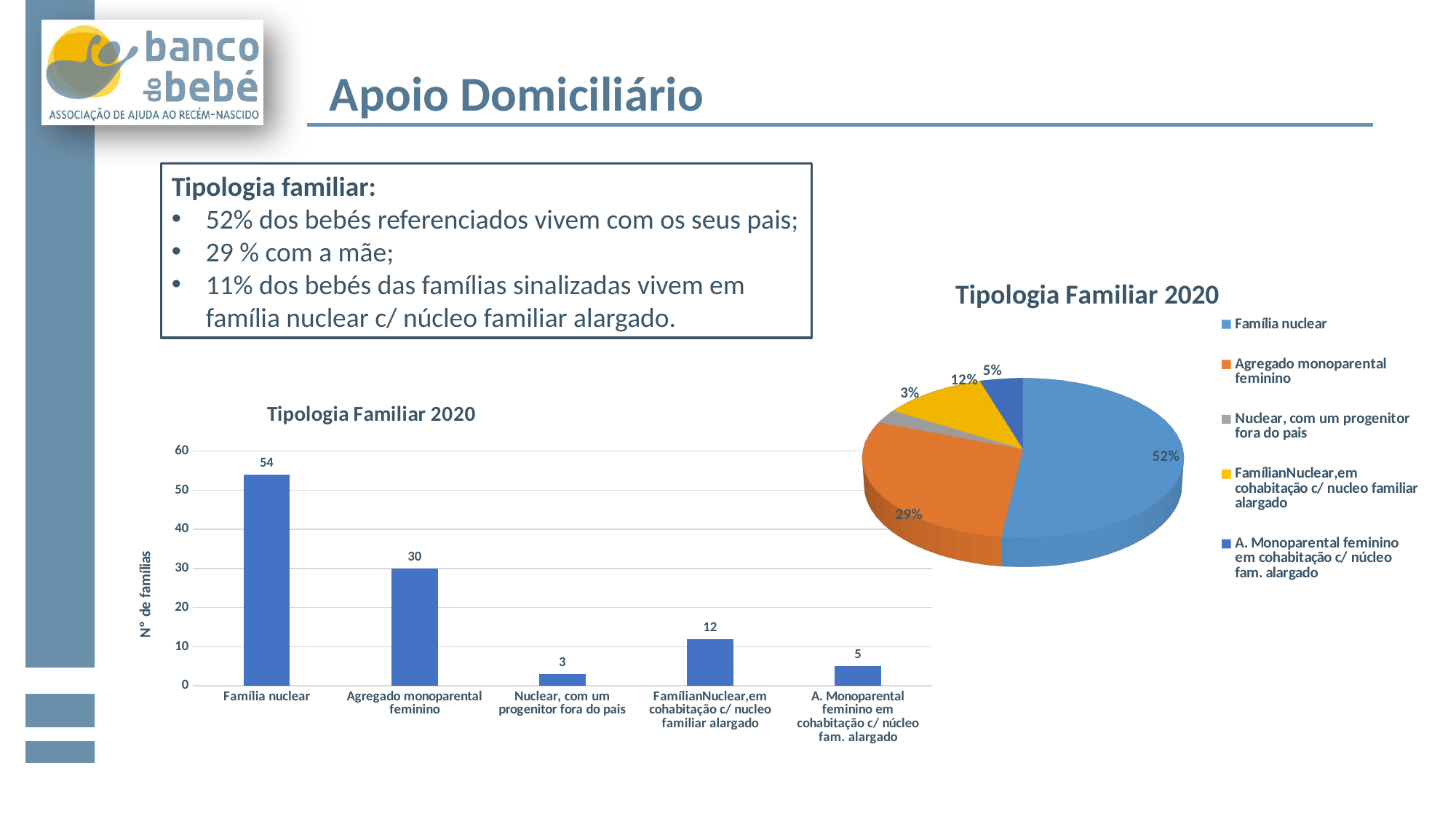
In the pie chart on the right, what share does Família nuclear have? 52% How many categories are shown in the bar chart on the left? 5 In the bar chart on the left, which is larger: FamílianNuclear,em cohabitação c/ nucleo familiar alargado or A. Monoparental feminino em cohabitação c/ núcleo fam. alargado? FamílianNuclear,em cohabitação c/ nucleo familiar alargado In the bar chart on the left, what is the value for Família nuclear? 54 In the bar chart on the left, what is the difference between Família nuclear and Agregado monoparental feminino? 24 In the pie chart on the right, what share does Agregado monoparental feminino have? 29% In the bar chart on the left, which category has the lowest value? Nuclear, com um progenitor fora do pais What type of chart is the chart on the left of the slide? bar chart What is the y-axis label of the bar chart on the left? Nº de famílias In the bar chart on the left, what is the value for Agregado monoparental feminino? 30 How many entries does the legend of the pie chart on the right list? 5 In the bar chart on the left, which category has the highest value? Família nuclear